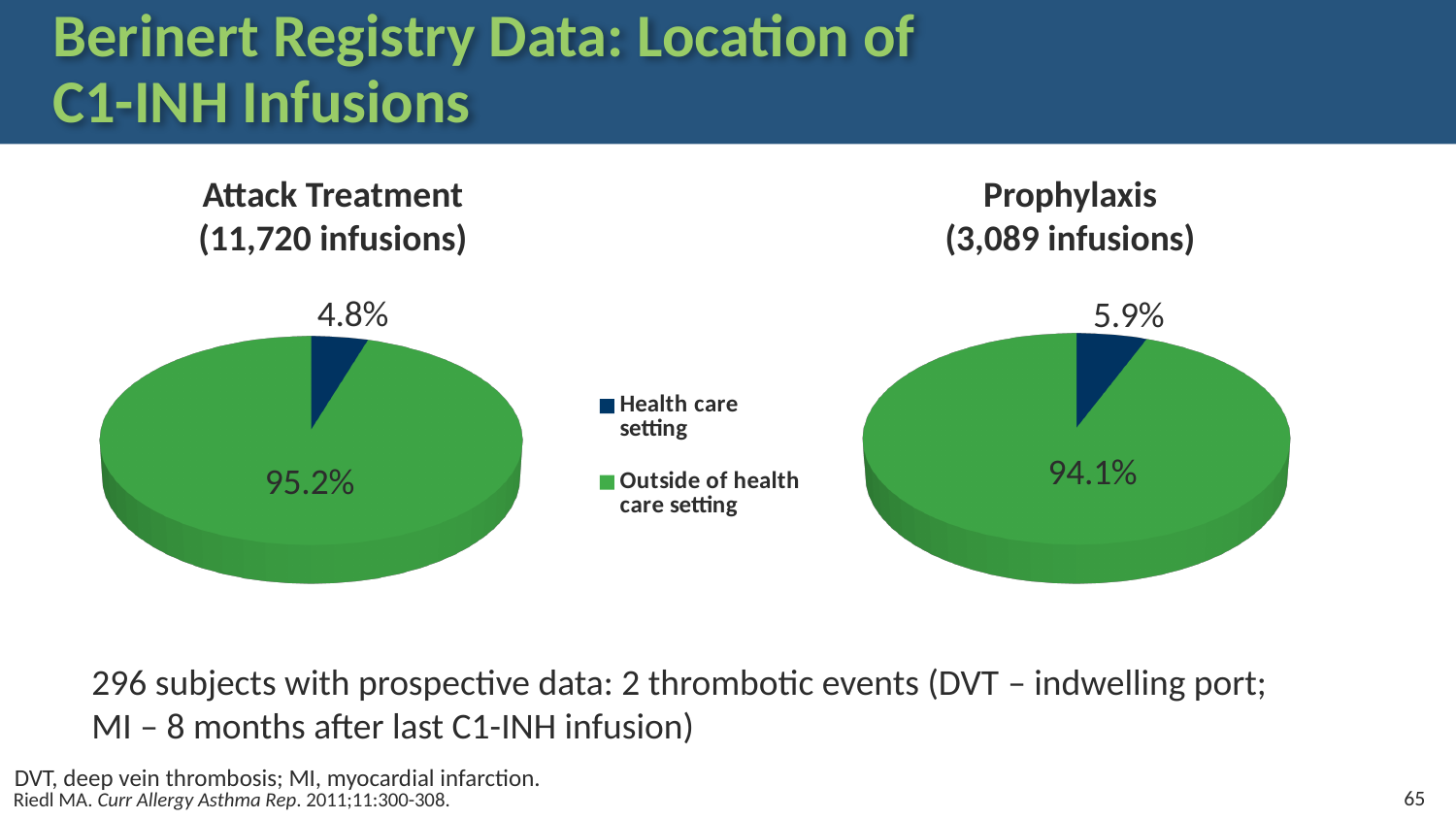
How many entries does the legend list? 2 In the Attack Treatment pie chart, what percentage of infusions were in a health care setting? 4.8% In the Prophylaxis pie chart, what percentage of infusions were outside of a health care setting? 94.1% How many infusions does the Prophylaxis chart title say it covers? 3,089 infusions How many slices does the Prophylaxis pie chart have? 2 In the Attack Treatment pie chart, which slice is the largest? Outside of health care setting What is the difference between the outside of health care setting shares in the Attack Treatment and Prophylaxis charts? 1.1% In the Prophylaxis pie chart, which slice is the smallest? Health care setting In the Prophylaxis pie chart, what percentage of infusions were in a health care setting? 5.9% Which chart has the larger share for health care setting, Attack Treatment or Prophylaxis? Prophylaxis In the Attack Treatment pie chart, what percentage of infusions were outside of a health care setting? 95.2% What type of chart is used for Attack Treatment? Pie chart